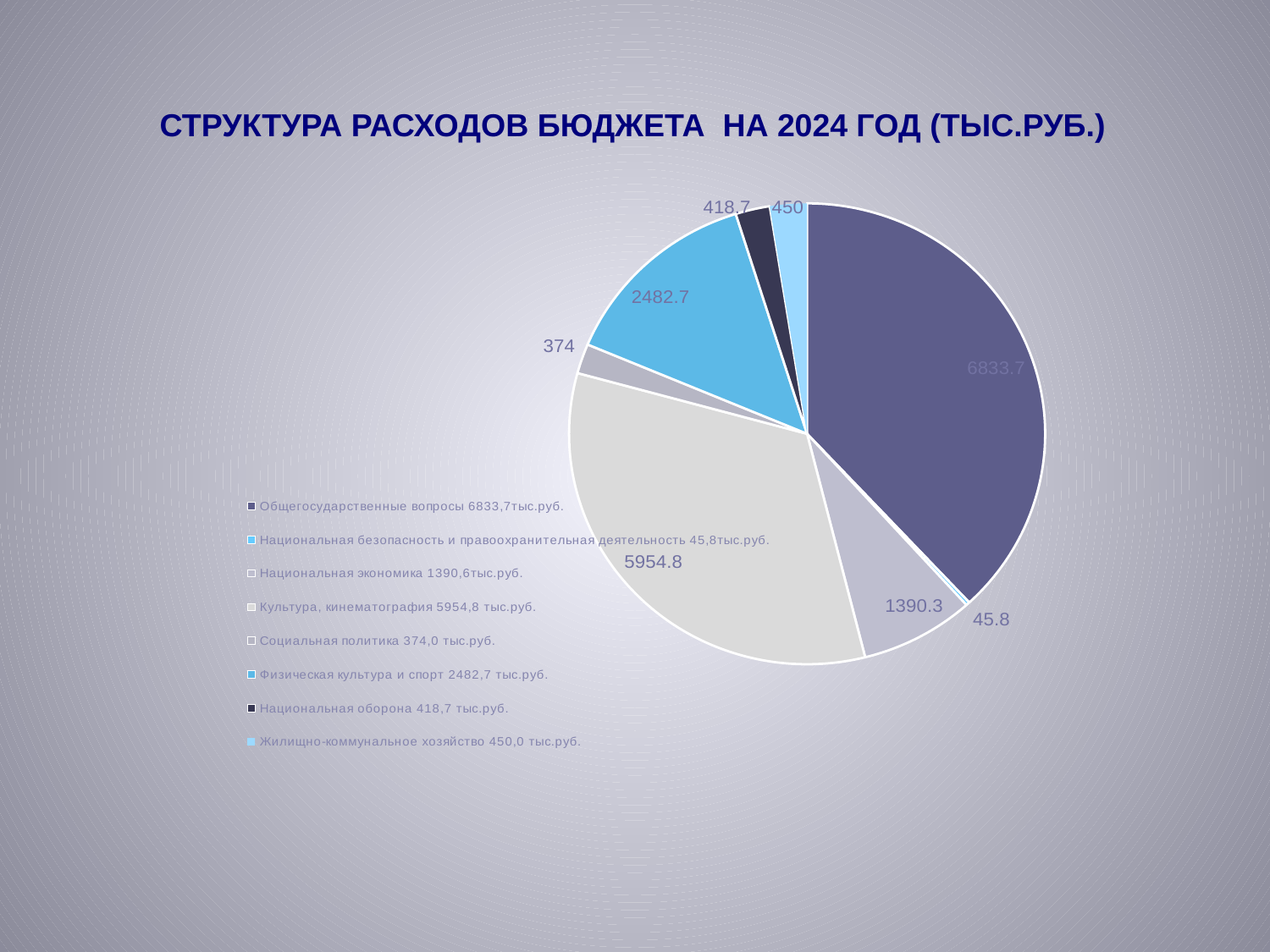
Which is larger: Национальная оборона or Жилищно-коммунальное хозяйство? Жилищно-коммунальное хозяйство What is the value for Жилищно-коммунальное хозяйство? 450 What is the value for Культура, кинематография? 5954.8 Which category has the smallest slice of the pie? Национальная безопасность и правоохранительная деятельность What is the difference between the values for Общегосударственные вопросы and Культура, кинематография? 878.9 What is the value for Национальная оборона? 418.7 Which category has the largest slice of the pie? Общегосударственные вопросы What is the value for Физическая культура и спорт? 2482.7 How many slices does the pie chart have? 8 What type of chart is shown on the slide? pie chart What is the title of the chart? СТРУКТУРА РАСХОДОВ БЮДЖЕТА НА 2024 ГОД (ТЫС.РУБ.) What is the value for Общегосударственные вопросы? 6833.7